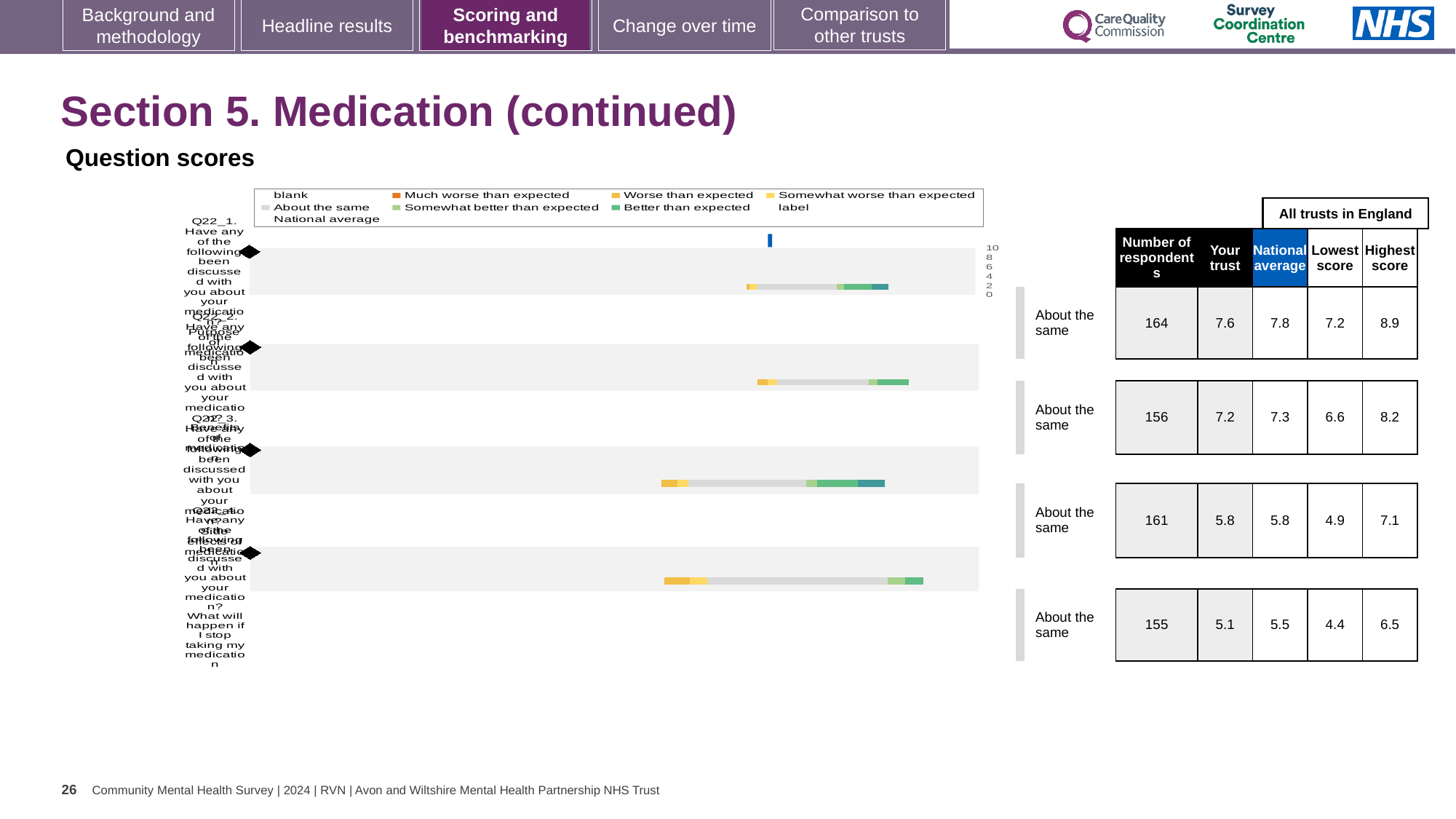
In the table beside the chart, what is the difference between the national average and 'Your trust' score for the fourth row (Q22_4)? 0.4 In the table beside the chart, what is the national average for the second row (Q22_2)? 7.3 In the table beside the chart, what is the highest score for the third row (Q22_3)? 7.1 In the table beside the chart, what is the 'Your trust' score for the first row (Q22_1)? 7.6 In the table beside the chart, which row has the lowest 'Your trust' score? Q22_4 (fourth row) In the table beside the chart, how many respondents are listed for the first row (Q22_1)? 164 What benchmark category is shown to the right of each bar in the chart? About the same What is the title of the chart section on the slide? Question scores What kind of chart is shown on the slide under 'Question scores'? bar chart How many horizontal bars are plotted in the chart? 4 In the table beside the chart, which row has the highest 'Your trust' score? Q22_1 (first row) In the table beside the chart, what is the lowest score for the fourth row (Q22_4)? 4.4